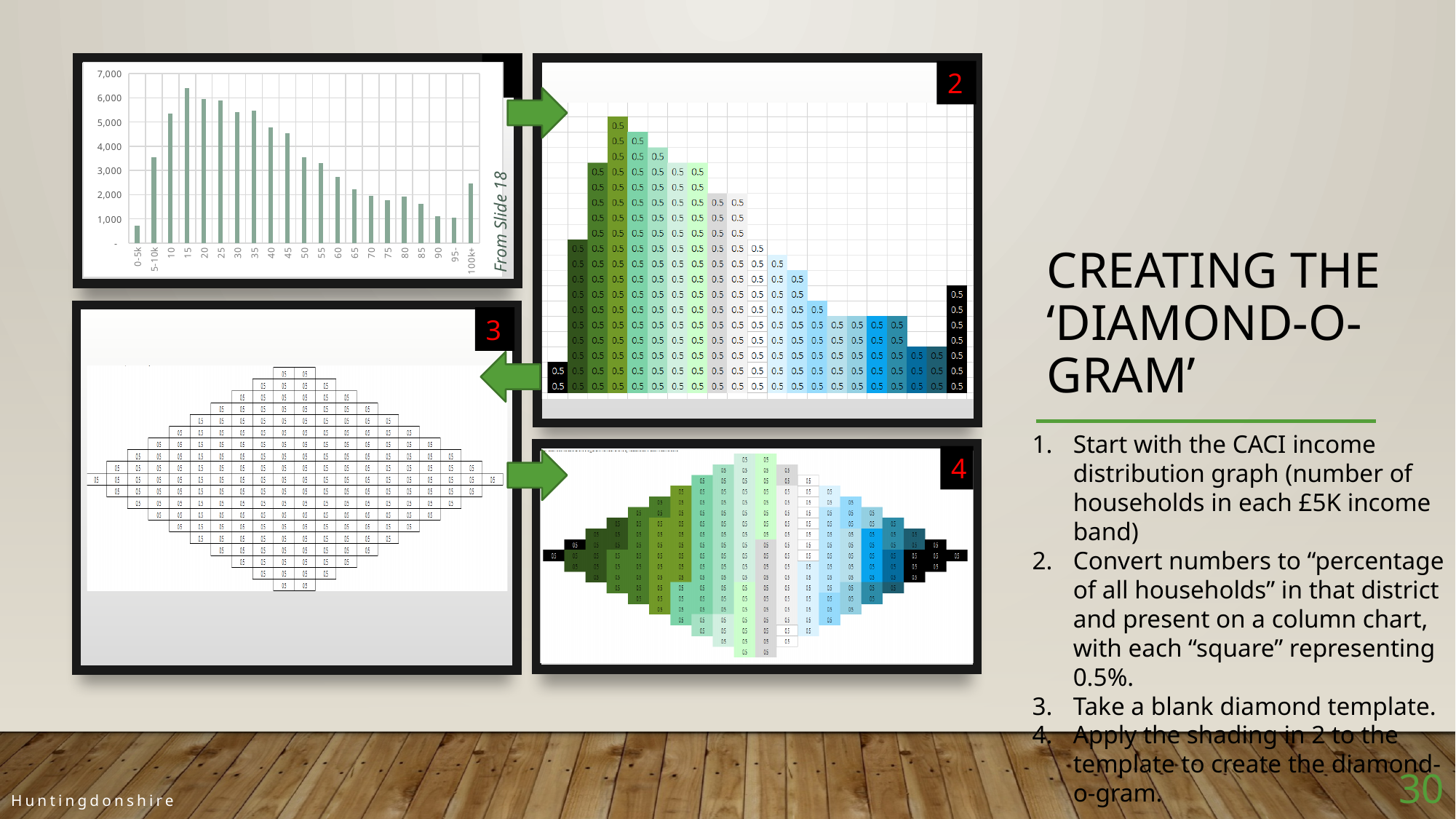
What is the highest value shown on the y axis of the top-left bar chart? 7,000 In the top-left bar chart, which income band has the highest bar? 15 In the top-left bar chart, is the value for the 0-5k band greater or less than 1,000? less In the top-left bar chart, how many income bands are shown on the x axis? 21 In the top-left bar chart, is the value for the 60 band greater or less than 3,000? less In the top-left bar chart, which income band has the lowest bar? 0-5k In the top-left bar chart, is the value for the 100k+ band greater or less than 2,000? greater In the top-left bar chart, do the bars generally rise or fall from the 15 band to the 95- band? fall In the top-left bar chart, which is larger: the bar for 5-10k or the bar for 10? 10 In the top-left bar chart, which is larger: the bar for 95- or the bar for 100k+? 100k+ What kind of chart is shown in the top-left panel (labelled 'From Slide 18')? bar chart